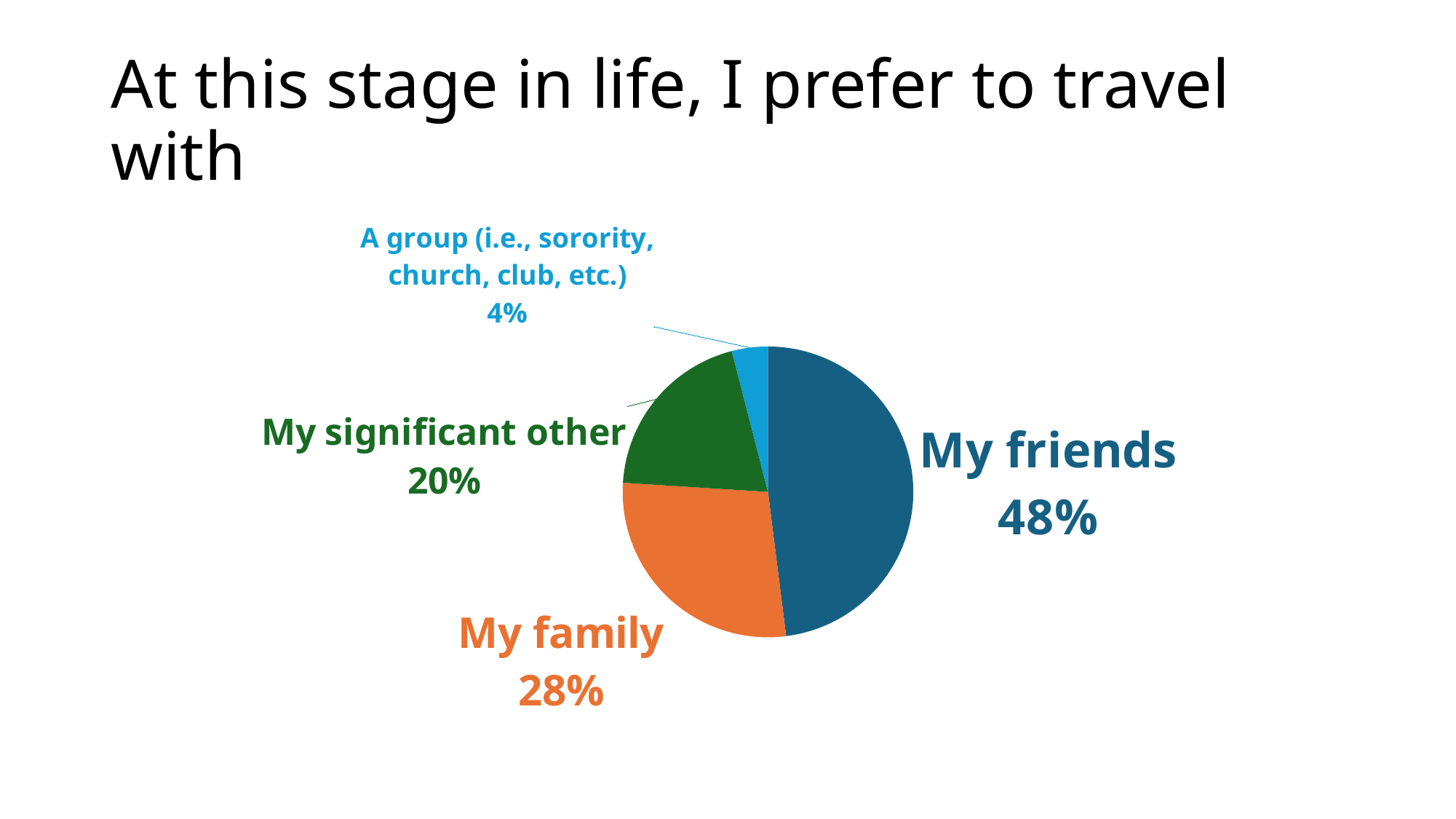
Which travel companion category has the smallest share of the pie? A group (i.e., sorority, church, club, etc.) What percentage of respondents prefer to travel with their friends? 48% Which travel companion category has the largest share of the pie? My friends What percentage of respondents prefer to travel with a group (i.e., sorority, church, club, etc.)? 4% What is the difference in percentage points between 'My significant other' and 'A group (i.e., sorority, church, club, etc.)'? 16 How many categories are shown in the pie chart? 4 Which is larger, the share for 'My family' or the share for 'My significant other'? My family What percentage of respondents prefer to travel with their family? 28% What colour is the 'My family' slice of the pie? Orange What type of chart is shown on the slide? Pie chart What percentage of respondents prefer to travel with their significant other? 20% How many percentage points higher is 'My friends' than 'My family'? 20